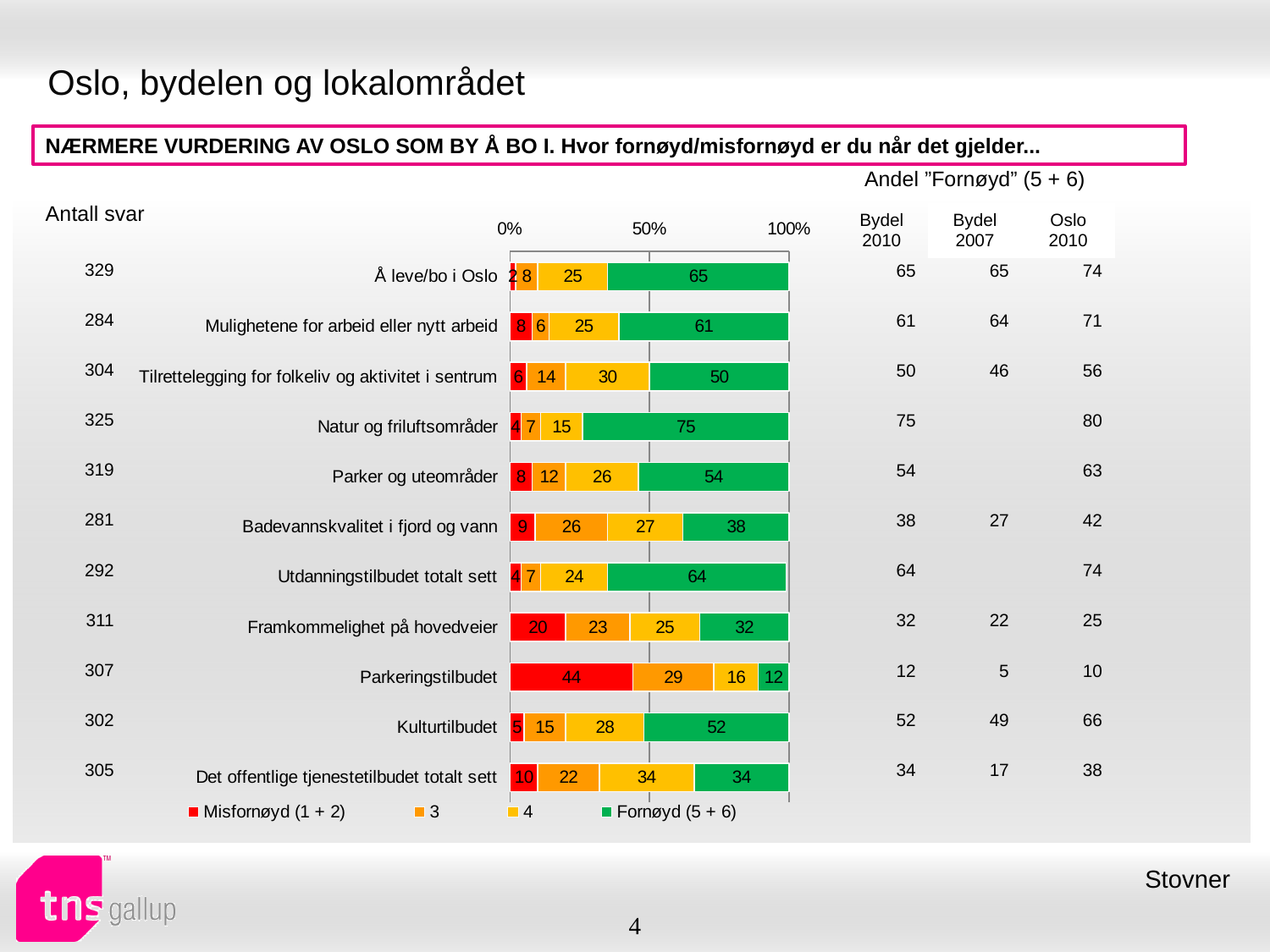
Which has a larger Fornøyd (5 + 6) value, Parker og uteområder or Badevannskvalitet i fjord og vann? Parker og uteområder What is the difference between the Fornøyd (5 + 6) values for Å leve/bo i Oslo and Kulturtilbudet? 13 How many categories are shown in the chart? 11 What is the value of series 4 for Det offentlige tjenestetilbudet totalt sett? 34 Which category has the lowest Fornøyd (5 + 6) value? Parkeringstilbudet How many series does the legend list? 4 What is the Fornøyd (5 + 6) value for Natur og friluftsområder? 75 What is the Misfornøyd (1 + 2) value for Parkeringstilbudet? 44 Which category has the highest Fornøyd (5 + 6) value? Natur og friluftsområder What kind of chart is shown on the slide? Stacked bar chart Which category has the highest Misfornøyd (1 + 2) value? Parkeringstilbudet What is the total of the stacked bar for Framkommelighet på hovedveier? 100